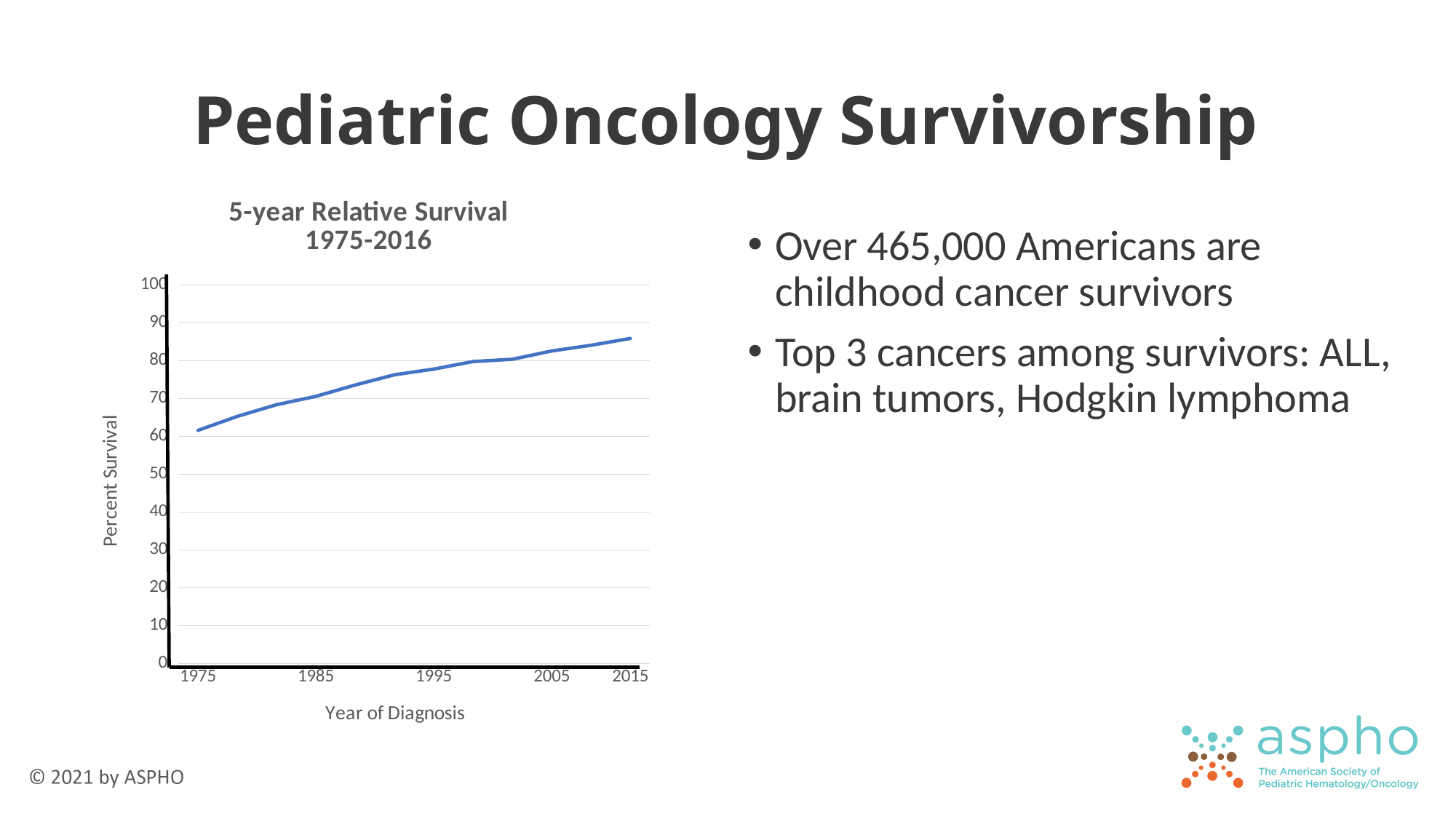
Which year shown on the x axis has the lowest 5-year relative survival? 1975 Does the 5-year relative survival rise or fall from 1975 to 2015? rise What is the title of the chart? 5-year Relative Survival 1975-2016 Is the value for 2015 greater or less than 90? less Is the value for 2005 greater or less than 80? greater Is the value for 1985 greater or less than 80? less What kind of chart is shown on the slide? line chart Which year has the higher 5-year relative survival, 1975 or 2015? 2015 What is the label of the y axis of the chart? Percent Survival